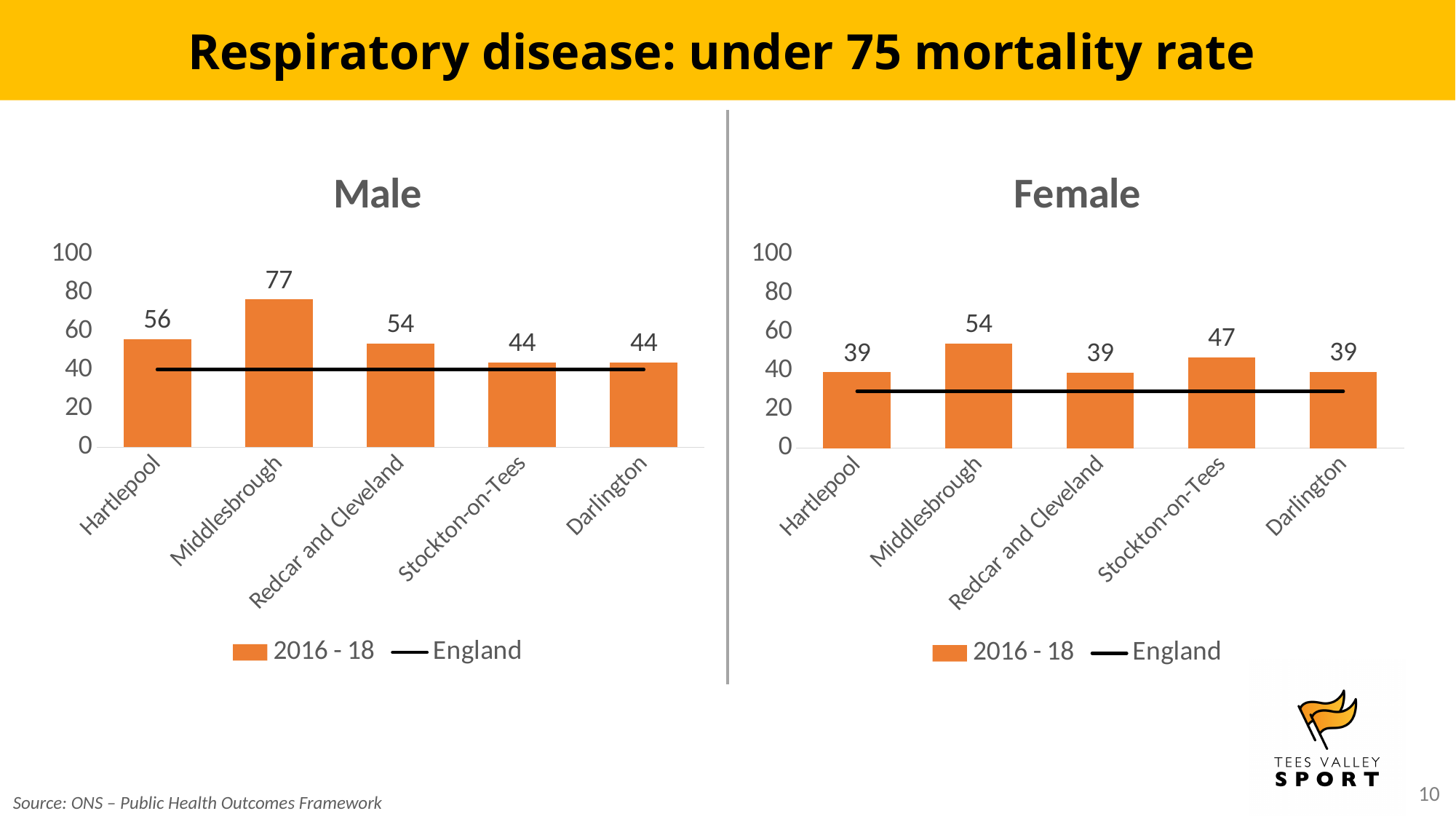
In the Male chart, what is the difference between Middlesbrough and Hartlepool? 21 How many series does the legend of the Male chart list? 2 What kind of chart is the Male chart? combination bar and line chart In the Male chart, what is the value for Middlesbrough? 77 In the Male chart, which is larger, Hartlepool or Redcar and Cleveland? Hartlepool In the Female chart, what is the difference between Middlesbrough and Darlington? 15 In the Female chart, which area has the highest value? Middlesbrough In the Female chart, what is the value for Stockton-on-Tees? 47 In the Male chart, is the England line greater or less than 60? less How many areas are shown in the Female chart? 5 In the Male chart, which area has the highest value? Middlesbrough In the Female chart, is the England line greater or less than 40? less